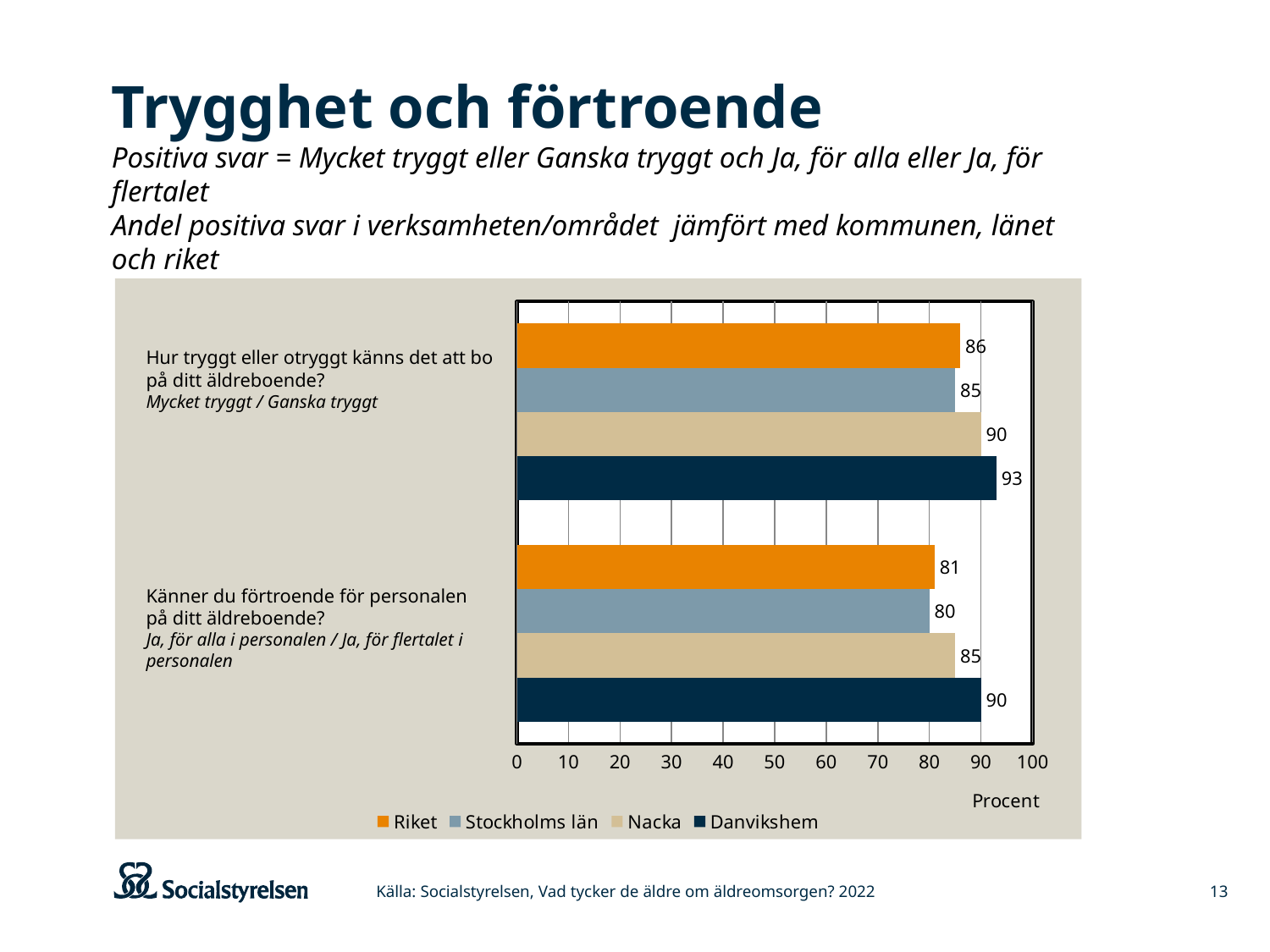
Which series has the lowest value on the question "Känner du förtroende för personalen på ditt äldreboende?"? Stockholms län What is the difference between Danvikshem and Riket on the question "Hur tryggt eller otryggt känns det att bo på ditt äldreboende?"? 7 What kind of chart is shown on the slide? Bar chart Which is larger on the question "Hur tryggt eller otryggt känns det att bo på ditt äldreboende?": Nacka or Riket? Nacka What is the value for Riket on the question "Känner du förtroende för personalen på ditt äldreboende?"? 81 What is the label of the x axis? Procent How many series does the legend list? 4 Which series has the highest value on the question "Känner du förtroende för personalen på ditt äldreboende?"? Danvikshem What is the value for Stockholms län on the question "Känner du förtroende för personalen på ditt äldreboende?"? 80 What is the value for Danvikshem on the question "Hur tryggt eller otryggt känns det att bo på ditt äldreboende?"? 93 What is the value for Nacka on the question "Hur tryggt eller otryggt känns det att bo på ditt äldreboende?"? 90 What is the difference between Danvikshem and Nacka on the question "Känner du förtroende för personalen på ditt äldreboende?"? 5